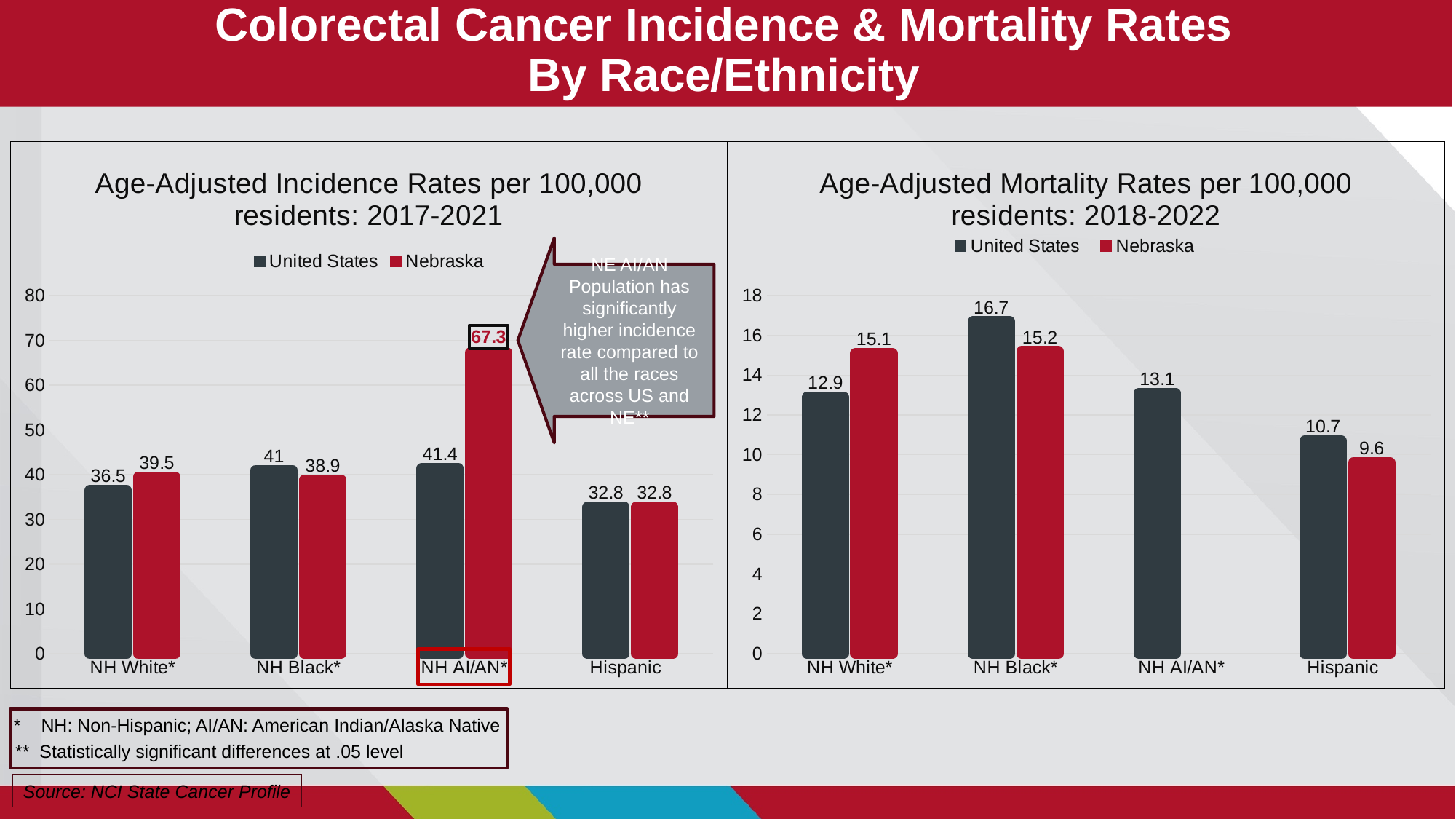
In the Age-Adjusted Mortality Rates chart, what is the difference between the Nebraska and United States values for NH White*? 2.2 In the Age-Adjusted Incidence Rates chart, what is the United States value for NH White*? 36.5 How many series does the legend of the Age-Adjusted Mortality Rates chart list? 2 In the Age-Adjusted Mortality Rates chart, what is the United States value for NH Black*? 16.7 In the Age-Adjusted Mortality Rates chart, what is the Nebraska value for Hispanic? 9.6 In the Age-Adjusted Incidence Rates chart, what is the difference between the Nebraska and United States values for NH AI/AN*? 25.9 In the Age-Adjusted Mortality Rates chart, which is larger for NH Black*: the United States value or the Nebraska value? United States In the Age-Adjusted Incidence Rates chart, what is the Nebraska value for NH AI/AN*? 67.3 In the Age-Adjusted Mortality Rates chart, which category has the lowest United States value? Hispanic How many categories are shown on the x axis of the Age-Adjusted Incidence Rates chart? 4 In the Age-Adjusted Incidence Rates chart, which category has the highest Nebraska value? NH AI/AN* What type of chart is the Age-Adjusted Incidence Rates chart? Bar chart